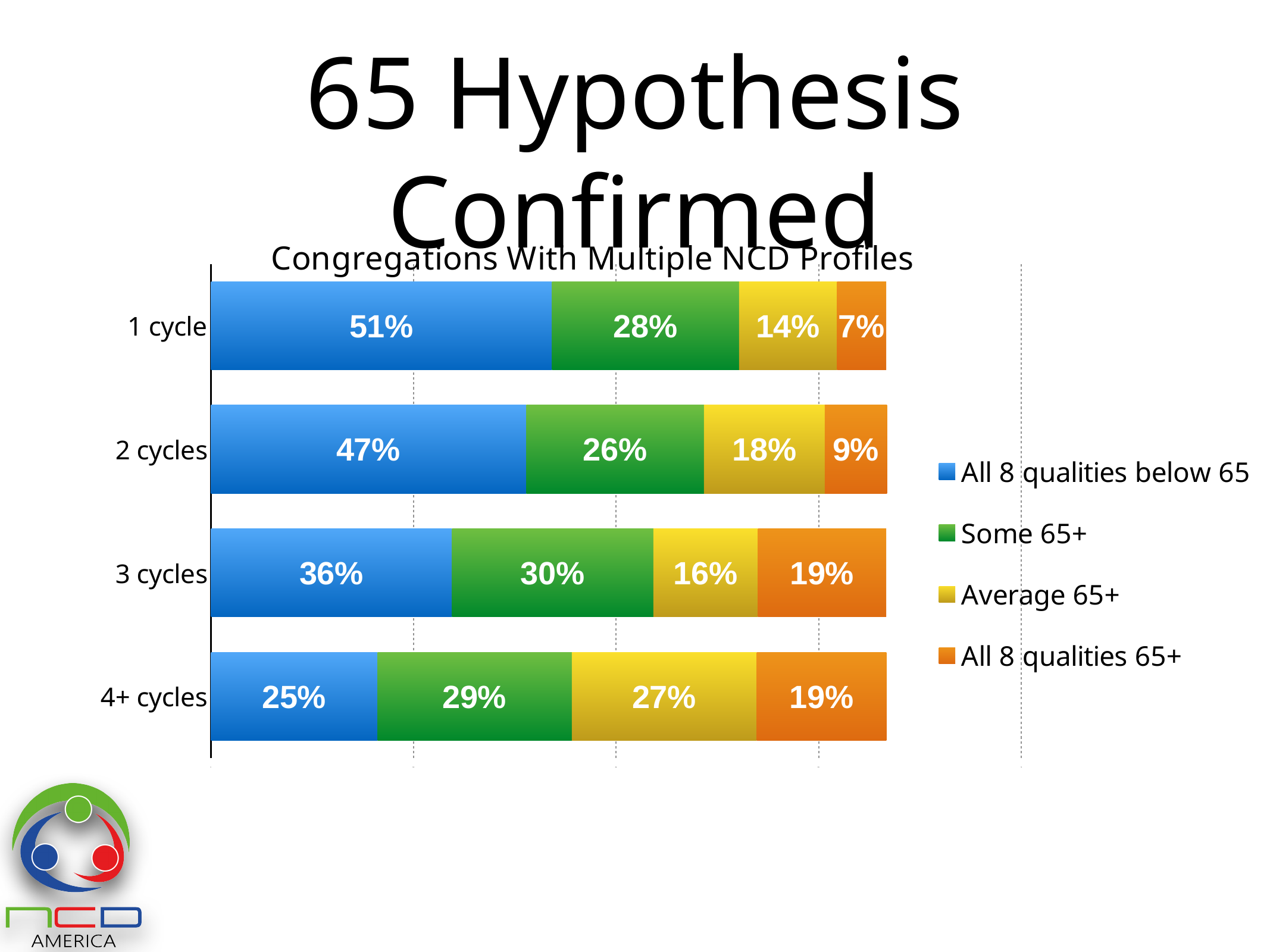
What is the value for "Some 65+" for 3 cycles? 30% What is the difference between the "All 8 qualities below 65" values for 1 cycle and 4+ cycles? 26% How many categories are shown on the chart? 4 Which category has the highest value for "All 8 qualities below 65"? 1 cycle Does the "All 8 qualities below 65" value rise or fall from 1 cycle to 4+ cycles? Fall Which is larger: the "Average 65+" value for 2 cycles or for 3 cycles? 2 cycles What is the value for "All 8 qualities below 65" for 1 cycle? 51% What is the value for "All 8 qualities 65+" for 2 cycles? 9% How many series does the legend list? 4 What is the value for "Average 65+" for 4+ cycles? 27% Which category has the lowest value for "All 8 qualities 65+"? 1 cycle What kind of chart is shown on the slide? Stacked bar chart